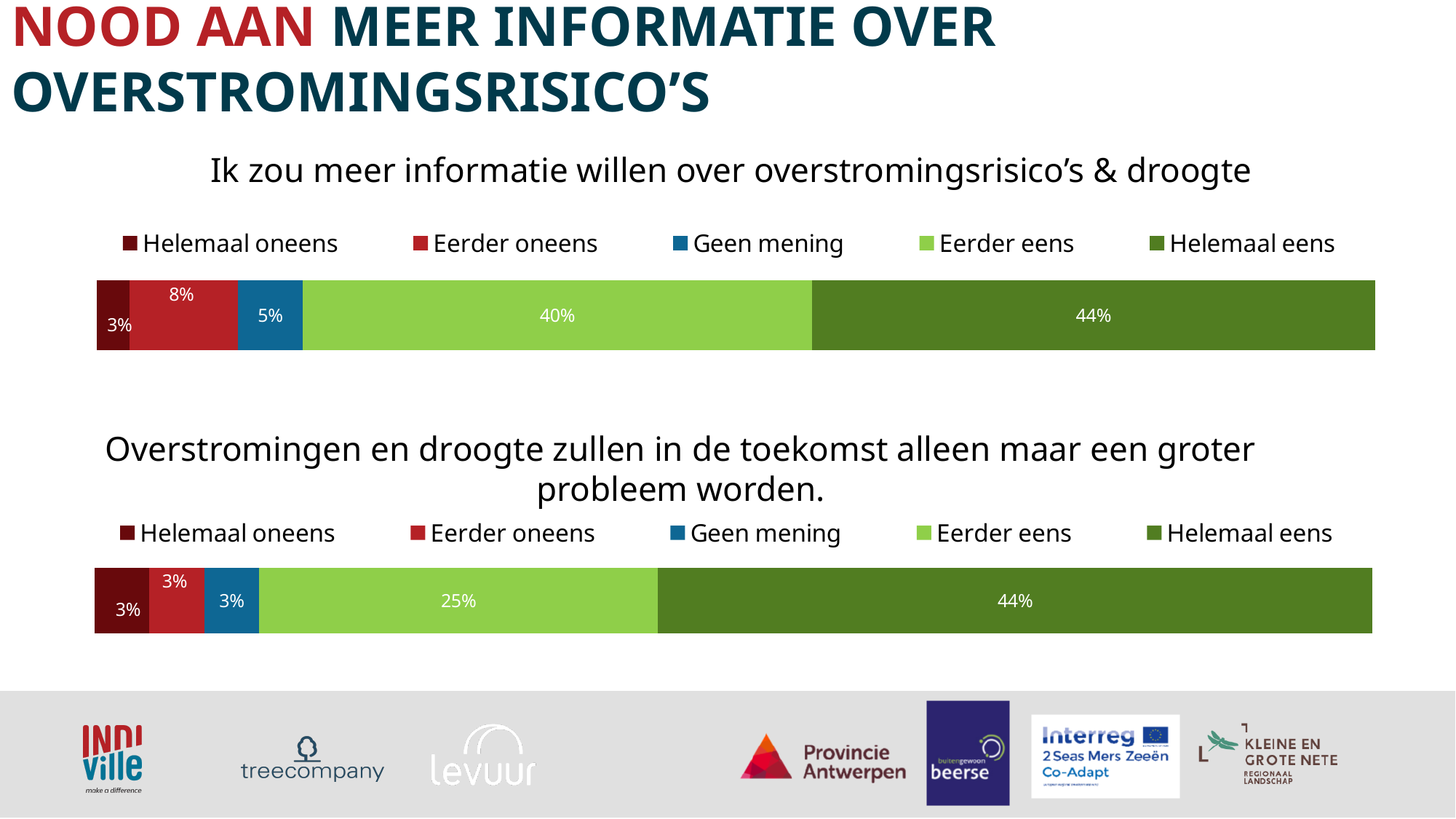
In the top chart 'Ik zou meer informatie willen over overstromingsrisico's & droogte', which response category has the largest share? Helemaal eens In the bottom chart 'Overstromingen en droogte zullen in de toekomst alleen maar een groter probleem worden.', what percentage is shown for 'Geen mening'? 3% In the top chart 'Ik zou meer informatie willen over overstromingsrisico's & droogte', what percentage is shown for 'Geen mening'? 5% In the top chart 'Ik zou meer informatie willen over overstromingsrisico's & droogte', what percentage is shown for 'Helemaal eens'? 44% In the bottom chart 'Overstromingen en droogte zullen in de toekomst alleen maar een groter probleem worden.', what is the difference between 'Helemaal eens' and 'Eerder eens'? 19% In the top chart 'Ik zou meer informatie willen over overstromingsrisico's & droogte', what is the difference between 'Helemaal eens' and 'Eerder eens'? 4% In the top chart 'Ik zou meer informatie willen over overstromingsrisico's & droogte', what percentage is shown for 'Eerder oneens'? 8% In the top chart 'Ik zou meer informatie willen over overstromingsrisico's & droogte', which response category has the smallest share? Helemaal oneens In the top chart 'Ik zou meer informatie willen over overstromingsrisico's & droogte', which is larger: 'Eerder oneens' or 'Geen mening'? Eerder oneens In the bottom chart 'Overstromingen en droogte zullen in de toekomst alleen maar een groter probleem worden.', what percentage is shown for 'Eerder eens'? 25% How many series does the legend of the top chart 'Ik zou meer informatie willen over overstromingsrisico's & droogte' list? 5 What kind of chart is the bottom chart 'Overstromingen en droogte zullen in de toekomst alleen maar een groter probleem worden.'? Stacked bar chart